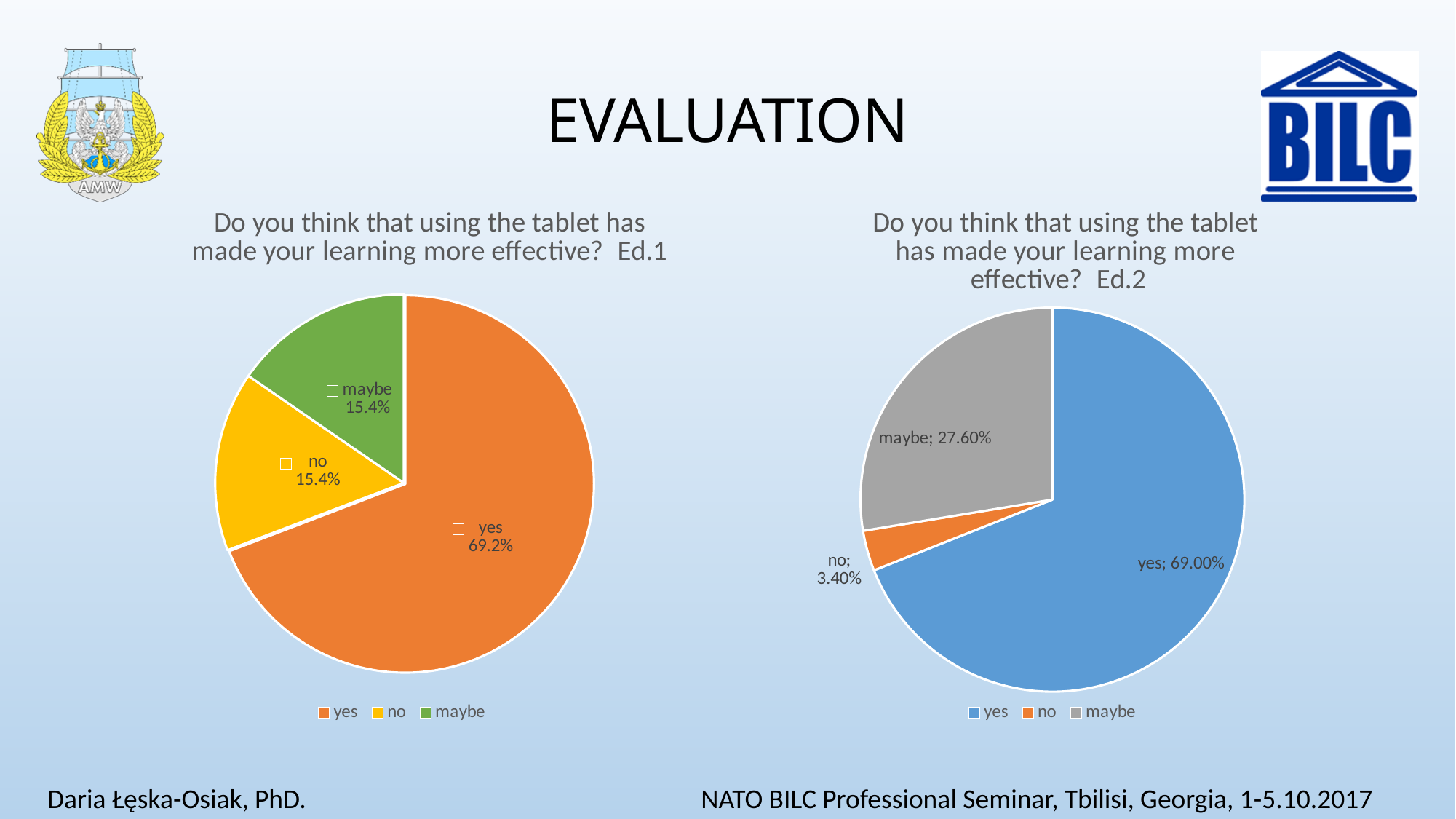
In the Ed.2 pie chart on the right, which answer has the smallest share? no How many slices does the Ed.1 pie chart on the left have? 3 In the Ed.2 pie chart on the right, what is the value for "no"? 3.40% In the Ed.2 pie chart on the right, which is larger, the share for "maybe" or the share for "no"? maybe In the Ed.1 pie chart on the left, which answer has the largest share? yes In the Ed.1 pie chart on the left, what is the value for "maybe"? 15.4% In the Ed.2 pie chart on the right, what is the difference between the "yes" and "maybe" shares? 41.40% What kind of chart is the chart on the left of the slide? Pie chart How many entries does the legend of the Ed.2 pie chart on the right list? 3 In the Ed.1 pie chart on the left, what share of respondents answered "yes"? 69.2% In the Ed.2 pie chart on the right, what colour is the "yes" slice? Blue In the Ed.2 pie chart on the right, what share of respondents answered "maybe"? 27.60%